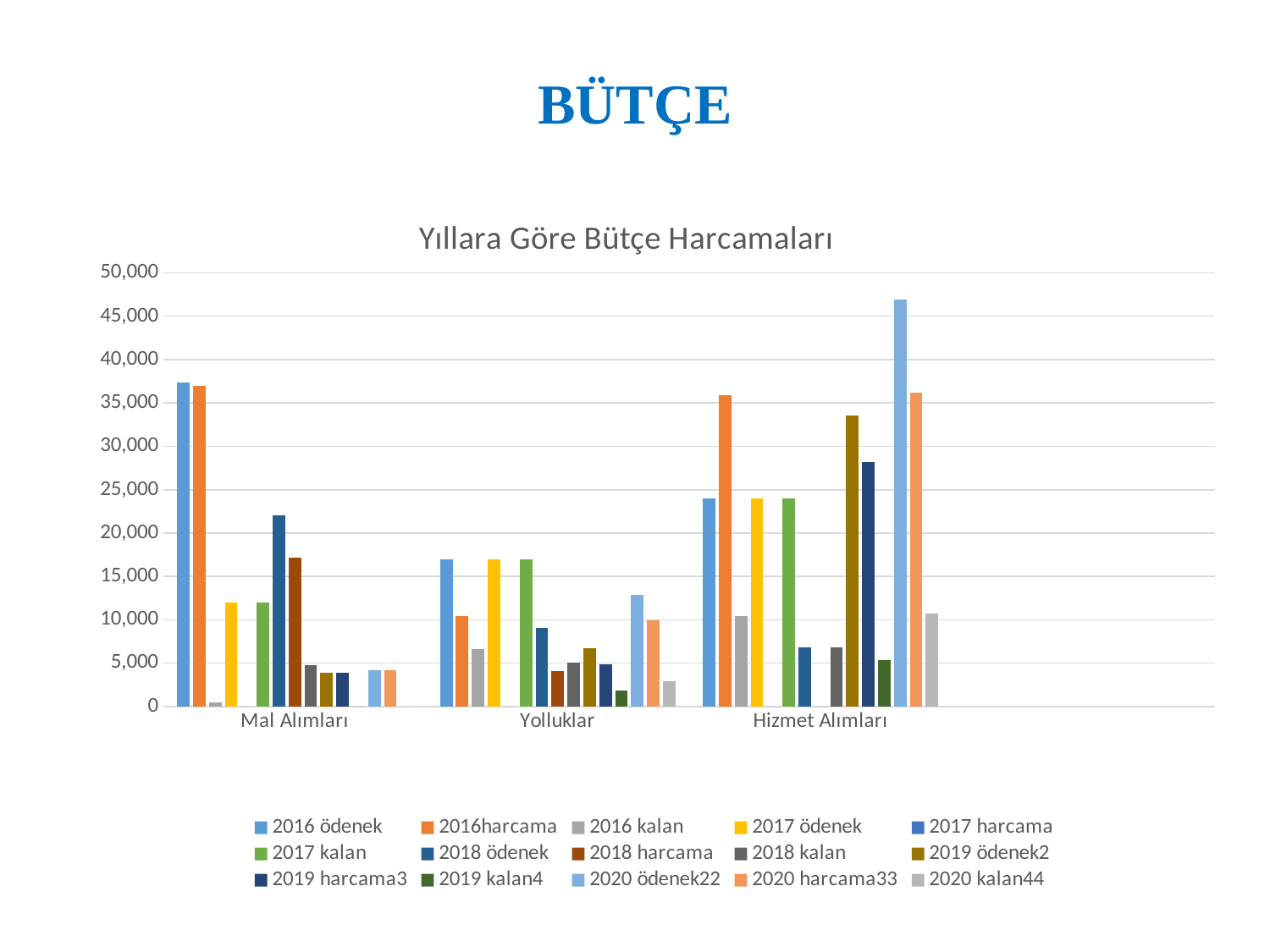
What kind of chart is shown on the slide? Bar chart Which is larger in Hizmet Alımları: the 2016harcama value or the 2016 ödenek value? 2016harcama What is the title of the chart? Yıllara Göre Bütçe Harcamaları Is the value for 2016 ödenek in Yolluklar greater or less than 20,000? less How many categories are shown on the x axis of the chart? 3 Is the value for 2019 ödenek2 in Hizmet Alımları greater or less than 30,000? greater Which category has the lowest value for the 2016 ödenek series? Yolluklar Which category has the highest value for the 2020 ödenek22 series? Hizmet Alımları How many series does the chart's legend list? 15 Is the value for 2018 ödenek in Mal Alımları greater or less than 20,000? greater Which is larger: the 2016 ödenek value for Mal Alımları or for Hizmet Alımları? Mal Alımları